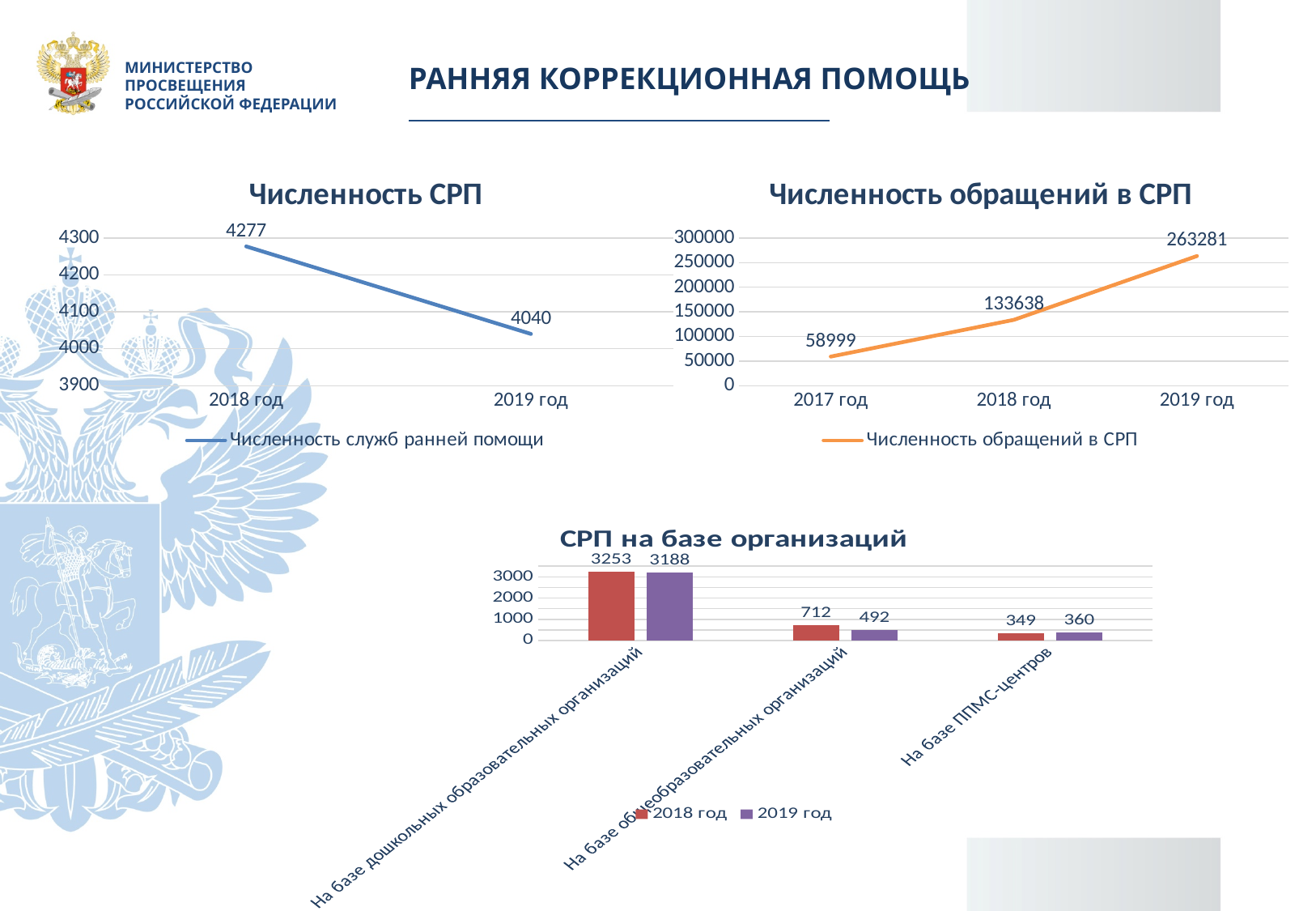
In the chart 'Численность обращений в СРП', what is the difference between 2019 год and 2018 год? 129643 In the chart 'СРП на базе организаций', what is the value for 2019 год for 'На базе общеобразовательных организаций'? 492 In the chart 'Численность обращений в СРП', what is the value for 2017 год? 58999 In the chart 'Численность обращений в СРП', which year has the highest value? 2019 год In the chart 'Численность СРП', do the values rise or fall from 2018 год to 2019 год? fall In the chart 'Численность СРП', by how much did the value fall from 2018 год to 2019 год? 237 In the chart 'Численность обращений в СРП', how many data points are plotted? 3 In the chart 'СРП на базе организаций', which is larger for 'На базе ППМС-центров': 2018 год or 2019 год? 2019 год In the chart 'Численность СРП', what is the value for 2019 год? 4040 In the chart 'Численность обращений в СРП', what type of chart is it? line chart In the chart 'СРП на базе организаций', what type of chart is it? bar chart In the chart 'СРП на базе организаций', how many series does the legend list? 2